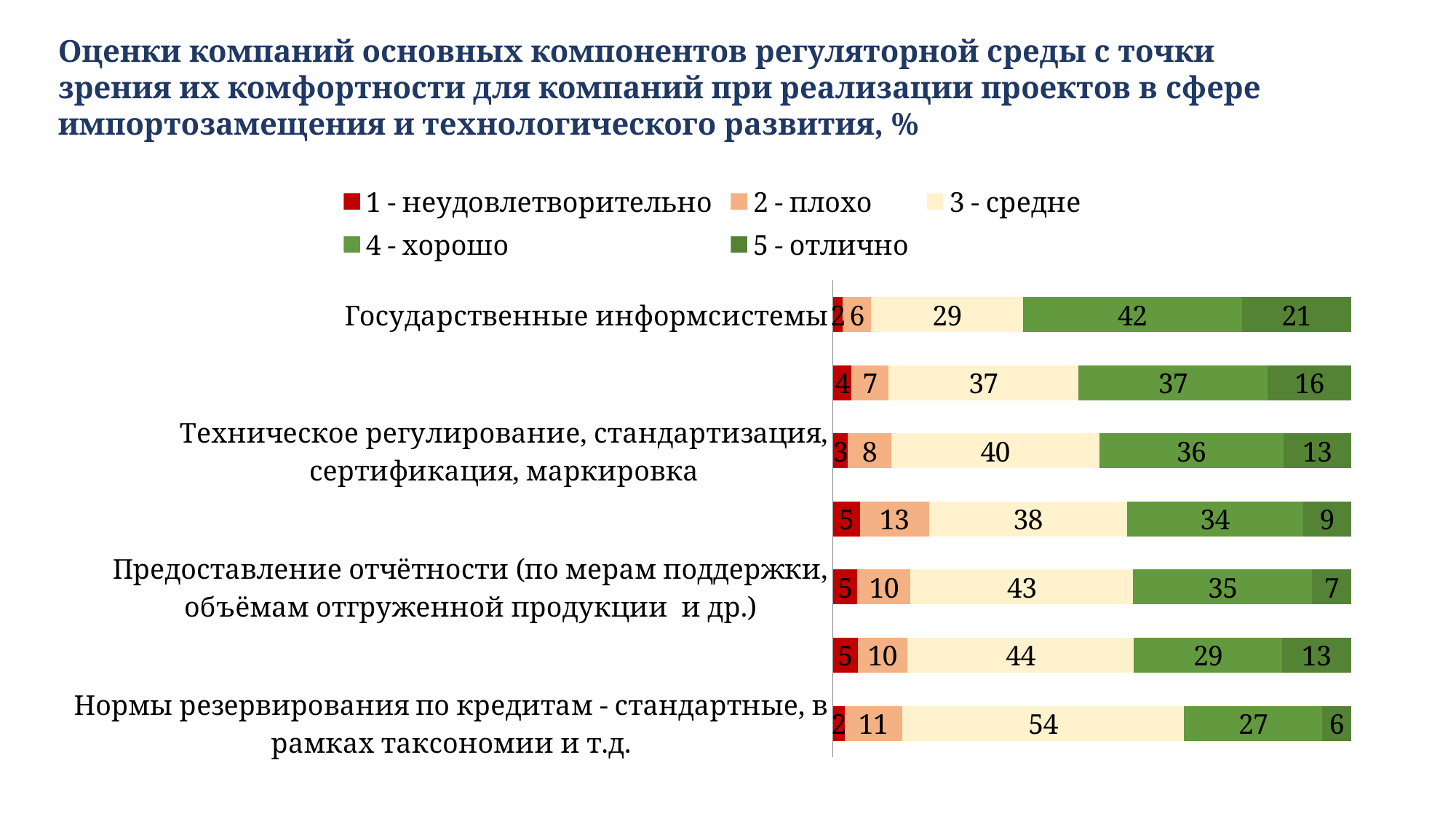
What is the value of "3 - средне" for "Нормы резервирования по кредитам - стандартные, в рамках таксономии и т.д."? 54 What is the value of "5 - отлично" for "Государственные информсистемы"? 21 What is the value of "2 - плохо" for "Предоставление отчётности (по мерам поддержки, объёмам отгруженной продукции и др.)"? 10 What is the total of the stacked bar for "Государственные информсистемы"? 100 How many bars are plotted in the chart? 7 How many series does the legend list? 5 What kind of chart is shown on the slide? Stacked bar chart Which has a larger value for "1 - неудовлетворительно": "Предоставление отчётности (по мерам поддержки, объёмам отгруженной продукции и др.)" or "Государственные информсистемы"? Предоставление отчётности (по мерам поддержки, объёмам отгруженной продукции и др.) What is the value of "4 - хорошо" for "Техническое регулирование, стандартизация, сертификация, маркировка"? 36 What is the difference in "4 - хорошо" between "Государственные информсистемы" and "Нормы резервирования по кредитам - стандартные, в рамках таксономии и т.д."? 15 Which category has the highest value for "3 - средне"? Нормы резервирования по кредитам - стандартные, в рамках таксономии и т.д. Which category has the highest value for "5 - отлично"? Государственные информсистемы